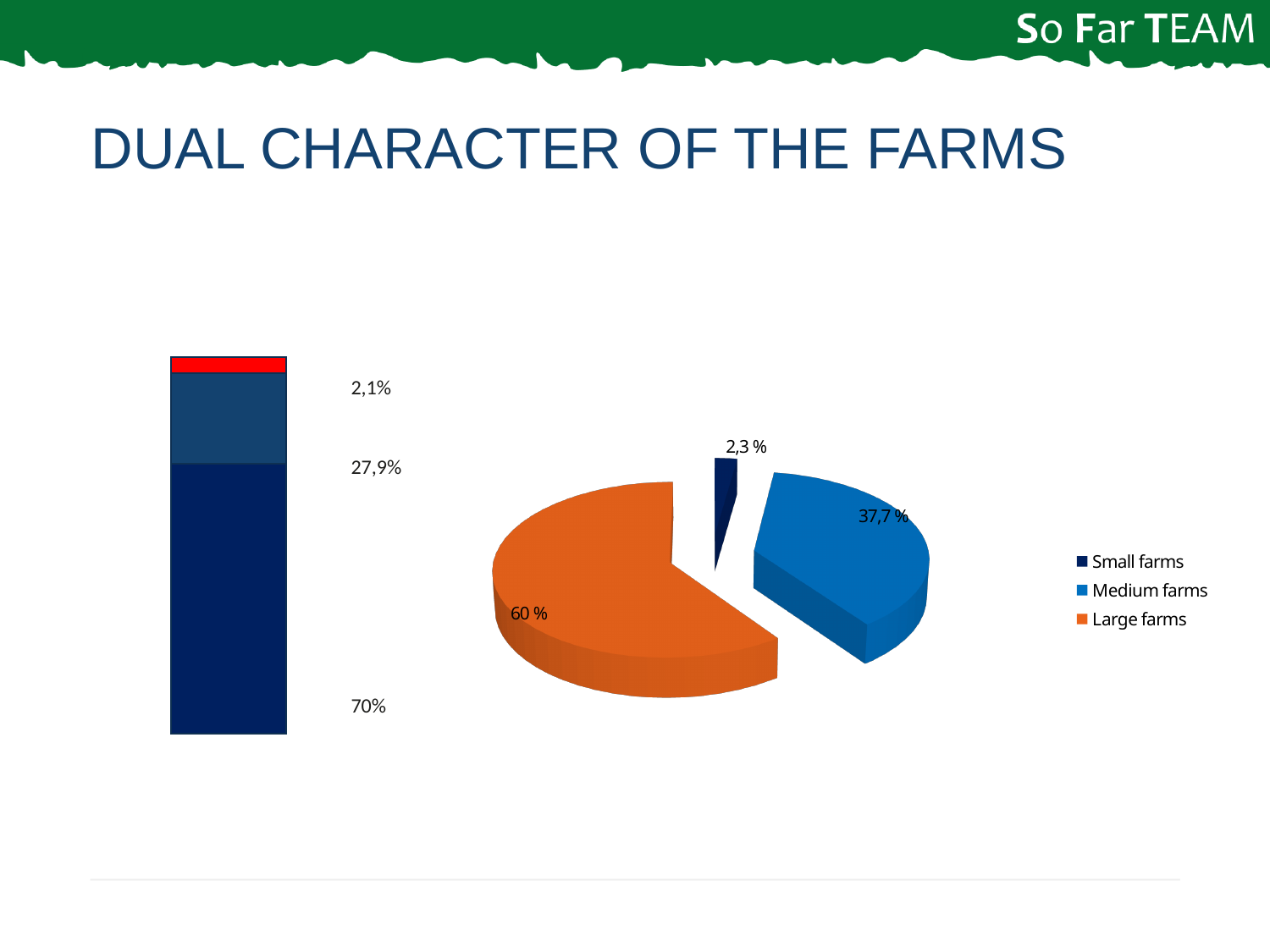
In the pie chart on the right, which is larger: the share of Medium farms or the share of Small farms? Medium farms What kind of chart is shown on the right of the slide? Pie chart How many entries does the legend of the pie chart on the right list? 3 In the pie chart on the right, what share is shown for Large farms? 60 % In the pie chart on the right, which category has the smallest slice? Small farms In the pie chart on the right, what share is shown for Medium farms? 37,7 % In the pie chart on the right, what is the difference between the shares of Large farms and Medium farms? 22,3 % What kind of chart is shown on the left of the slide? Bar chart What is the largest value labelled on the stacked bar on the left of the slide? 70% In the pie chart on the right, which category has the largest slice? Large farms How many segments does the stacked bar on the left of the slide have? 3 In the pie chart on the right, what share is shown for Small farms? 2,3 %